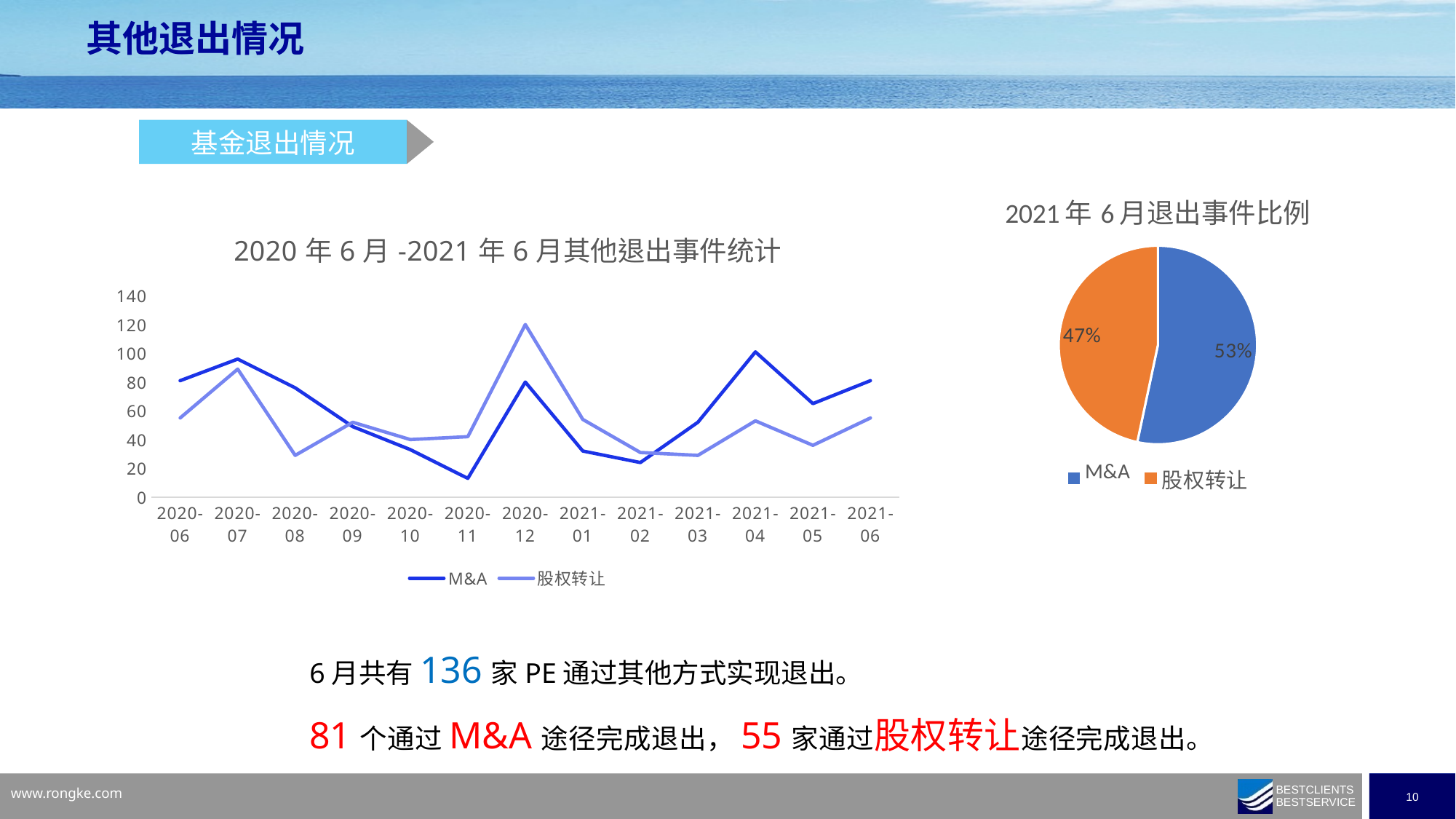
In the pie chart titled 2021年6月退出事件比例, what share does 股权转让 have? 47% In the pie chart titled 2021年6月退出事件比例, which colour represents 股权转让? Orange How many months are plotted along the x axis of the chart titled 2020年6月-2021年6月其他退出事件统计? 13 In the chart titled 2020年6月-2021年6月其他退出事件统计, does the M&A series rise or fall from 2020-07 to 2020-11? Fall In the pie chart titled 2021年6月退出事件比例, by how many percentage points does the M&A share exceed the 股权转让 share? 6 percentage points In the chart titled 2020年6月-2021年6月其他退出事件统计, in which month does the 股权转让 series reach its highest value? 2020-12 In the pie chart titled 2021年6月退出事件比例, which slice is larger, M&A or 股权转让? M&A What kind of chart is the chart titled 2020年6月-2021年6月其他退出事件统计? Line chart How many series does the legend of the chart titled 2020年6月-2021年6月其他退出事件统计 list? 2 In the chart titled 2020年6月-2021年6月其他退出事件统计, is the 股权转让 value for 2020-12 greater or less than 100? greater In the chart titled 2020年6月-2021年6月其他退出事件统计, in which month does the M&A series reach its lowest value? 2020-11 In the pie chart titled 2021年6月退出事件比例, what share does M&A have? 53%